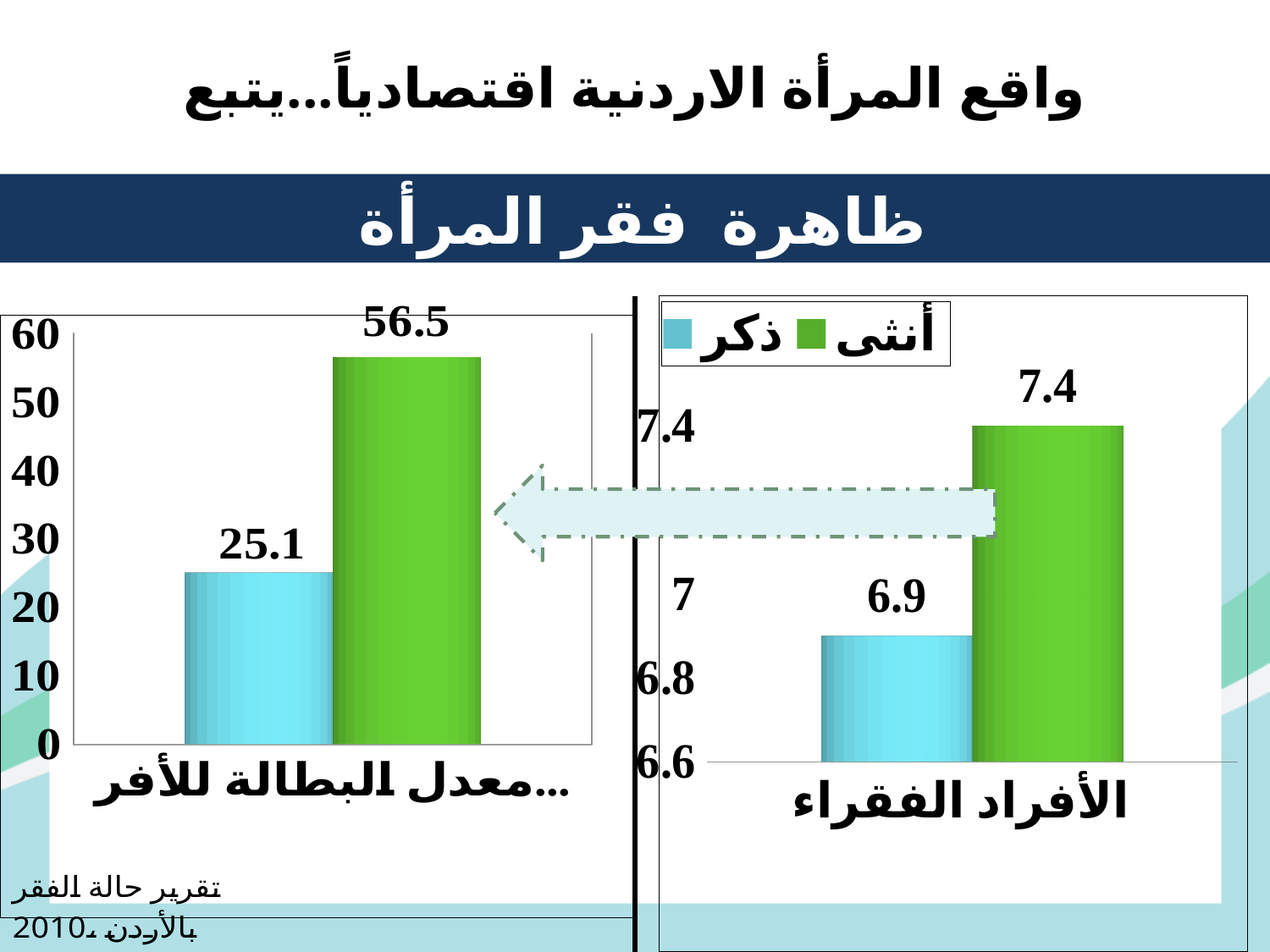
In the right chart, which series has the higher value, ذكر or أنثى? أنثى In the left chart, which bar is higher, the blue (ذكر) bar or the green (أنثى) bar? green (أنثى) In the left chart, is the value of the blue bar greater or less than 30? less How many series does the legend on the right chart list? 2 In the right chart (الأفراد الفقراء), what is the value for أنثى (female)? 7.4 In the left chart, what is the difference between the green bar (56.5) and the blue bar (25.1)? 31.4 Which colour represents أنثى in the legend of the right chart? green In the right chart, what is the difference between the أنثى value and the ذكر value? 0.5 In the left chart, what is the value of the green (أنثى) bar? 56.5 What type of chart is the right chart (الأفراد الفقراء)? bar chart In the right chart (الأفراد الفقراء), what is the value for ذكر (male)? 6.9 In the left chart, what is the value of the blue (ذكر) bar? 25.1